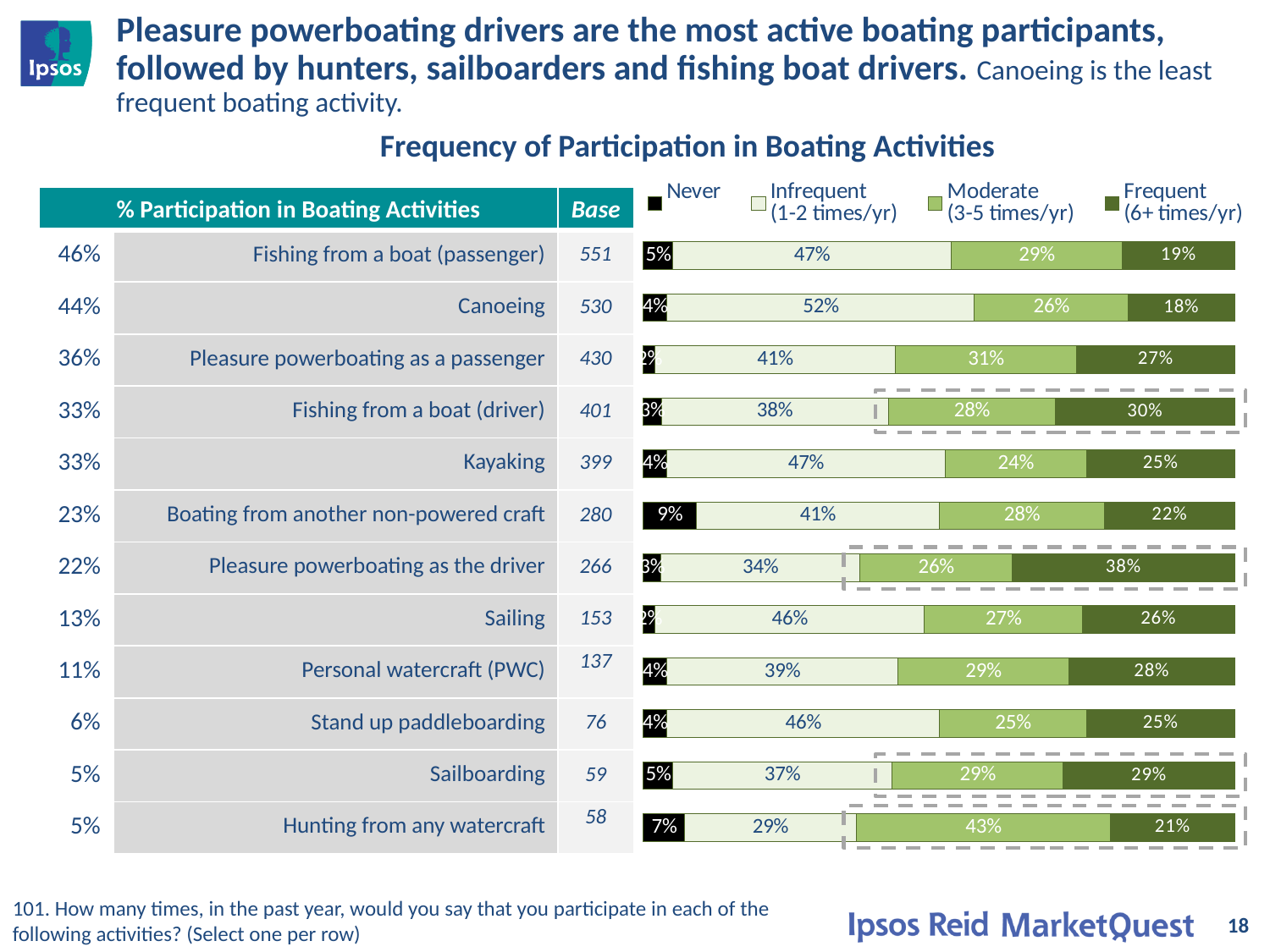
What is the Never value for Boating from another non-powered craft? 9% What is the Infrequent (1-2 times/yr) value for Canoeing? 52% How many frequency categories does the legend list? 4 What is the Moderate (3-5 times/yr) value for Hunting from any watercraft? 43% Which activity has the highest Frequent (6+ times/yr) share? Pleasure powerboating as the driver Which activity has the lowest Frequent (6+ times/yr) share? Canoeing Which activity has the highest Moderate (3-5 times/yr) share? Hunting from any watercraft Which has a larger Moderate (3-5 times/yr) share: Pleasure powerboating as a passenger or Kayaking? Pleasure powerboating as a passenger What type of chart is used to show the frequency of participation? Stacked bar chart What percentage of pleasure powerboating drivers participate frequently (6+ times/yr)? 38% How many boating activities are shown in the chart? 12 How many percentage points higher is the Frequent share for Fishing from a boat (driver) than for Fishing from a boat (passenger)? 11 percentage points